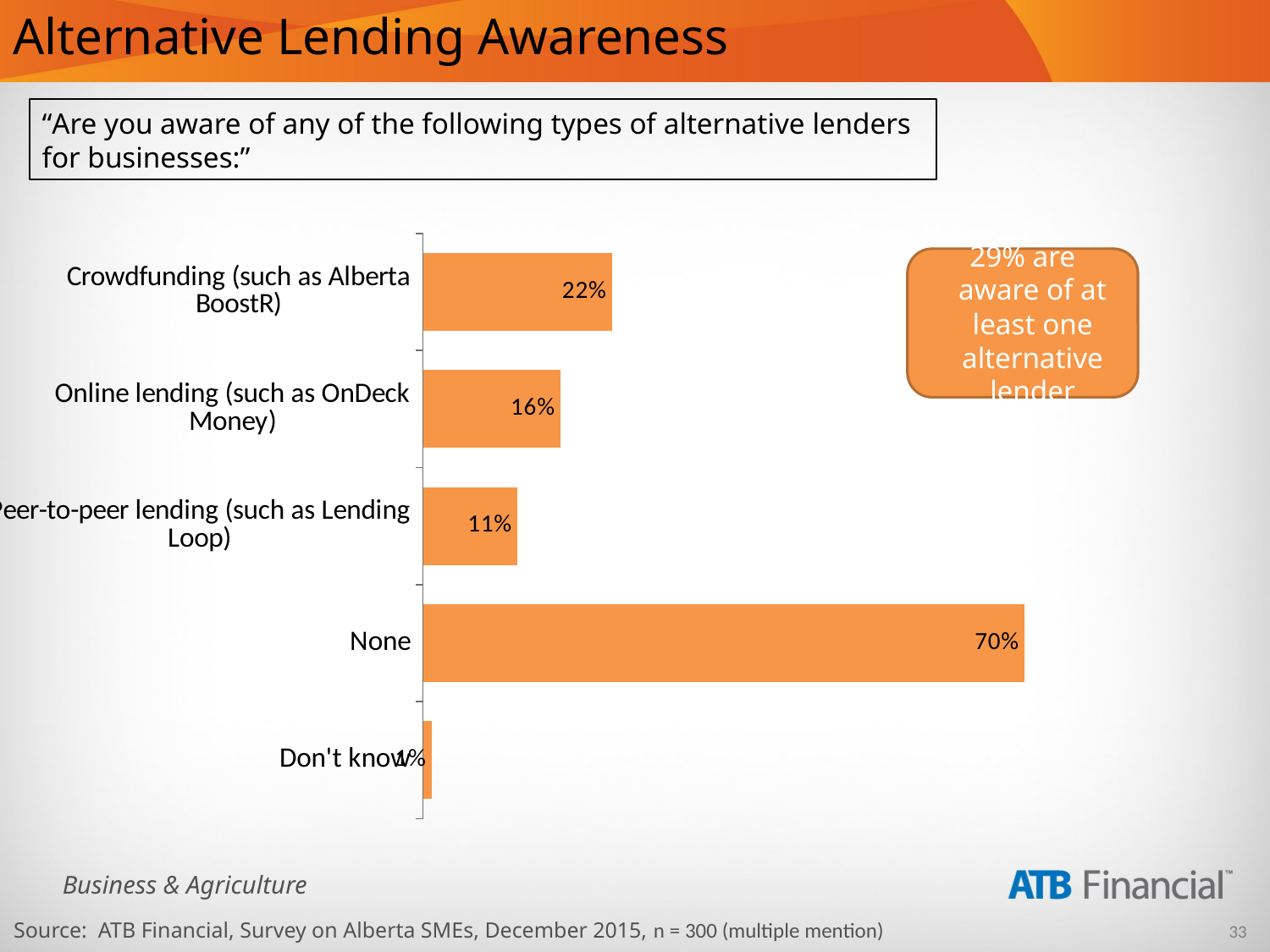
Which category has the highest value in the chart? None What percentage of respondents answered 'None'? 70% What percentage of respondents are aware of online lending (such as OnDeck Money)? 16% What percentage of respondents are aware of crowdfunding (such as Alberta BoostR)? 22% Which is larger: the value for online lending or the value for peer-to-peer lending? Online lending Which category has the lowest value in the chart? Don't know What is the difference between the crowdfunding value and the online lending value? 6% What is the difference between the 'None' value and the crowdfunding value? 48% What percentage of respondents answered 'Don't know'? 1% How many categories are shown in the chart? 5 What percentage of respondents are aware of peer-to-peer lending (such as Lending Loop)? 11% What kind of chart is shown on the slide? Bar chart